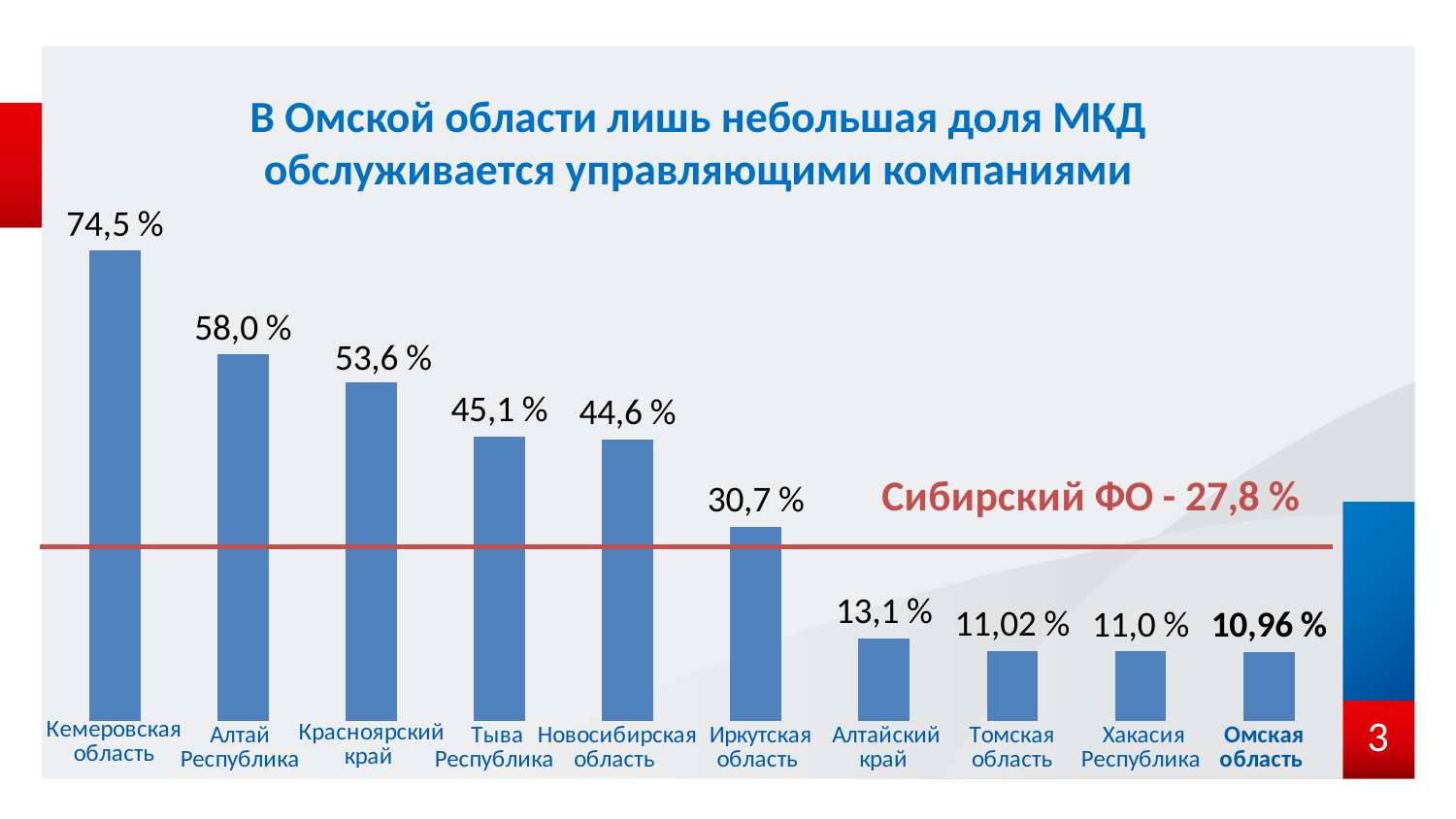
How many regions are shown in the chart? 10 Which region has the lowest value? Омская область Which region has the highest value? Кемеровская область What value is given for Сибирский ФО by the horizontal reference line? 27,8 % What is the value for Томская область? 11,02 % Which is larger, the value for Красноярский край or the value for Иркутская область? Красноярский край What is the value for Кемеровская область? 74,5 % What is the value for Омская область? 10,96 % What kind of chart is shown on the slide? Bar chart Do the values rise or fall from left to right along the x axis? Fall What is the value for Иркутская область? 30,7 % What is the difference between the values for Кемеровская область and Алтай Республика? 16,5 %